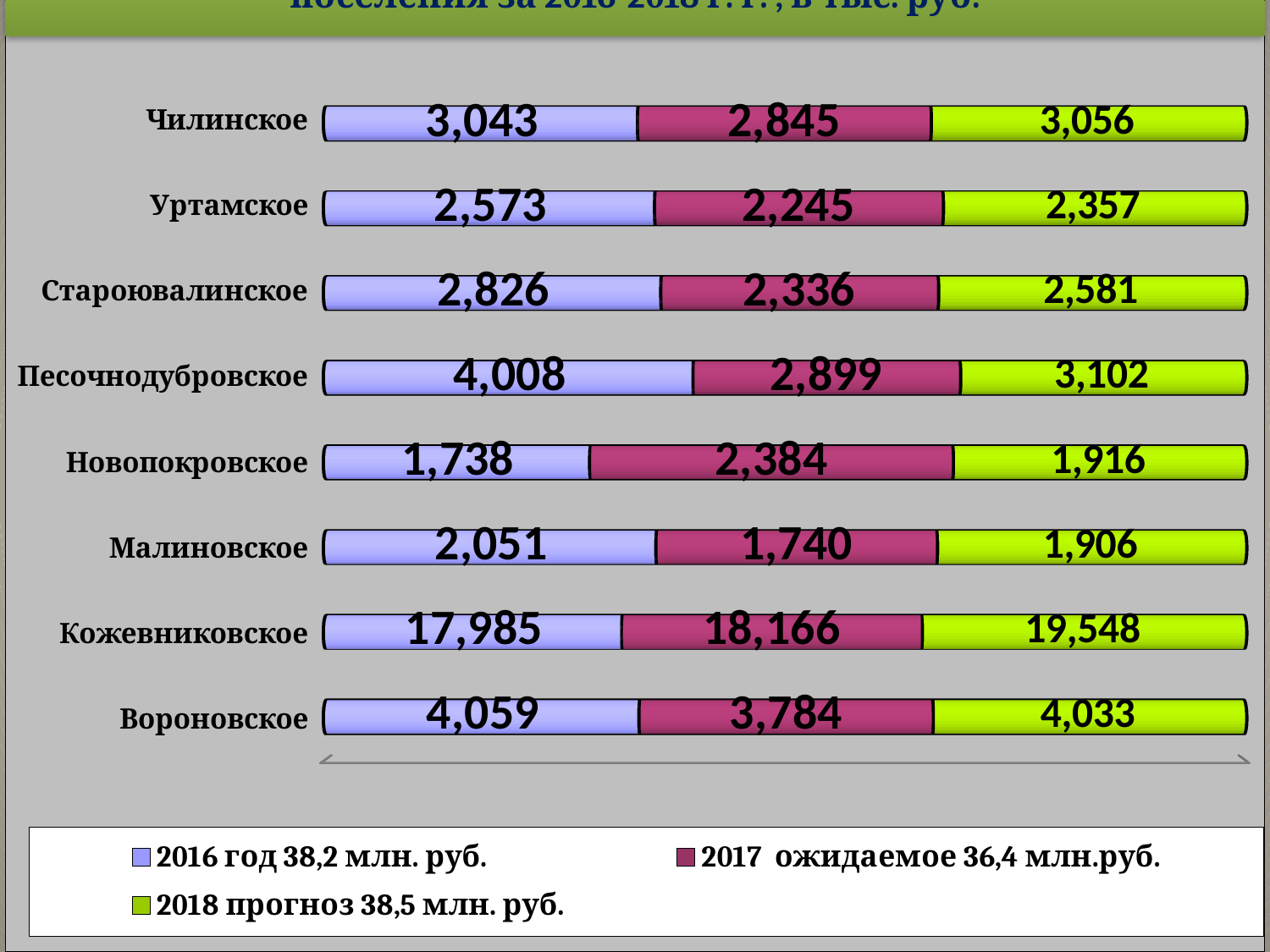
What kind of chart is shown on the slide? Stacked bar chart How many settlements are shown on the chart? 8 What is the 2016 год value for Чилинское? 3,043 Which settlement has the highest 2016 год value? Кожевниковское What is the 2018 прогноз value for Кожевниковское? 19,548 For Песочнодубровское, which is larger: the 2016 год value or the 2018 прогноз value? 2016 год What is the difference between the 2016 год and 2017 ожидаемое values for Вороновское? 275 What is the 2017 ожидаемое value for Новопокровское? 2,384 How many series does the legend list? 3 What is the difference between the 2018 прогноз and 2017 ожидаемое values for Кожевниковское? 1,382 Which settlement has the lowest 2016 год value? Новопокровское What is the total of the three values shown for Чилинское? 8,944